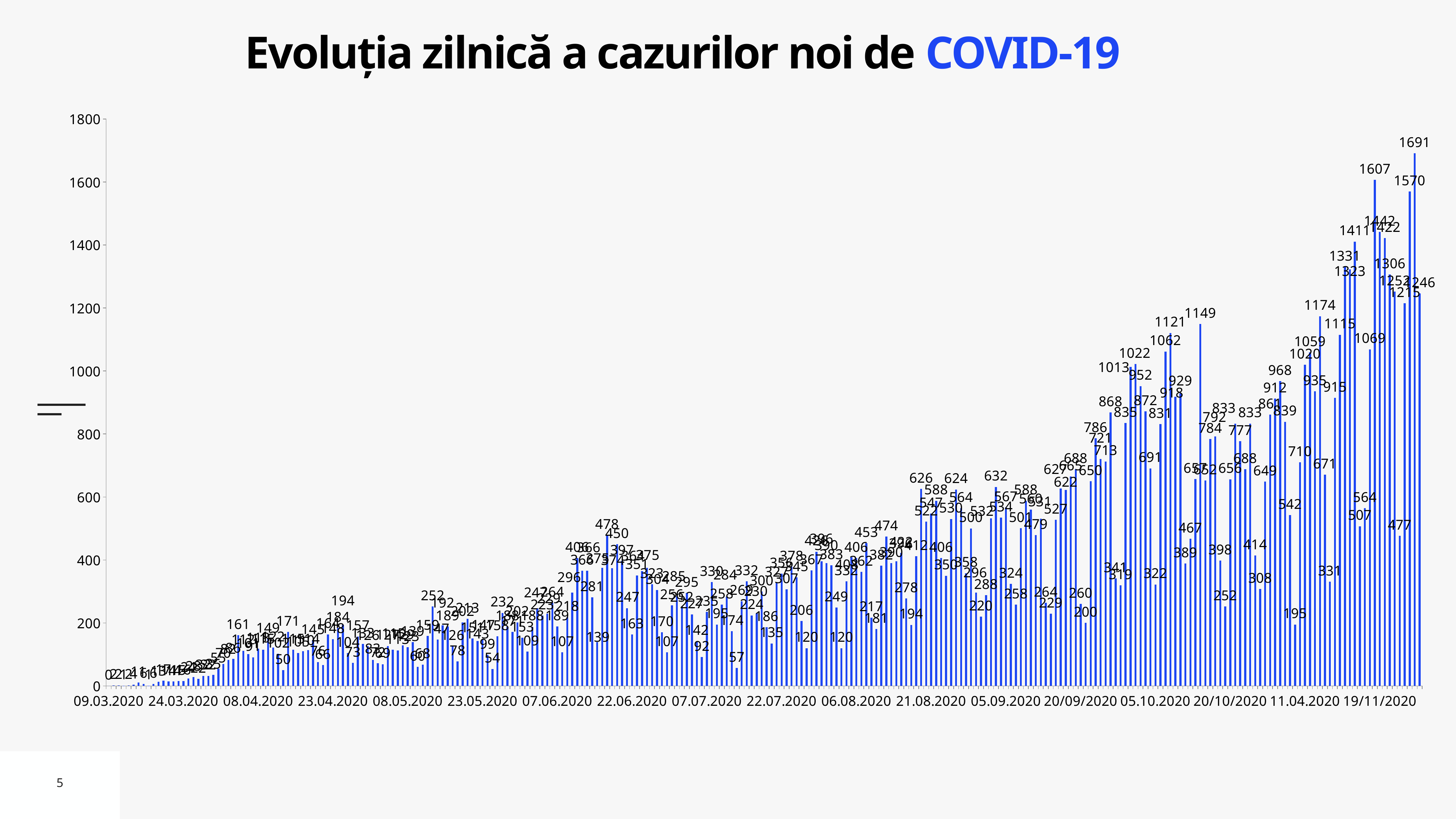
What is the title of the chart? Evoluția zilnică a cazurilor noi de COVID-19 What is the maximum value shown on the y axis? 1800 Is the value of the first bar on the chart greater or less than 200? less What kind of chart is shown on the slide? bar chart Is the bar labeled 1149 greater or less than 1000? greater What is the first date label shown on the x axis? 09.03.2020 Which is larger, the bar labeled 1691 or the bar labeled 1570? 1691 What is the highest daily value labeled on the chart? 1691 Is the highest value on the chart greater or less than 1600? greater What is the difference between the two highest labeled values, 1691 and 1607? 84 Do the daily values generally rise or fall from left to right along the x axis? rise